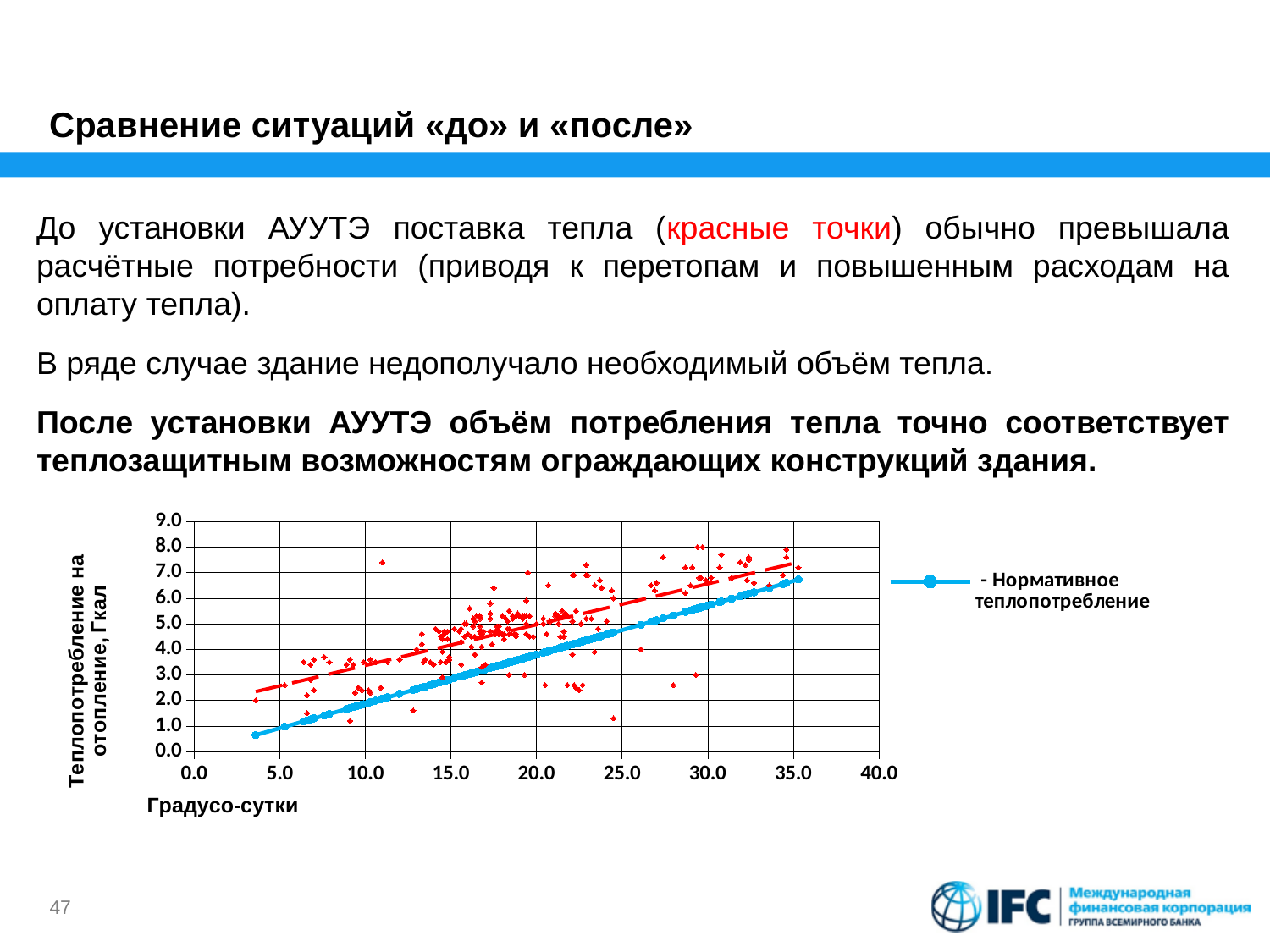
At 35.0 degree-days, which is higher: the red dashed trend line or the blue normative line? The red dashed trend line Is the blue normative heat consumption value at 35.0 degree-days greater or less than 6.0? greater What is the highest value shown on the y axis of the chart? 9.0 What is the legend entry shown next to the chart? - Нормативное теплопотребление What is the highest value shown on the x axis of the chart? 40.0 Do the blue normative heat consumption values rise or fall as the degree-days (Градусо-сутки) increase along the x axis? Rise Do the red points generally rise or fall as the x-axis value increases? Rise Is the blue normative heat consumption value at 25.0 degree-days greater or less than 5.0? less What kind of chart is shown on the slide? Scatter chart What is the title of the x axis of the chart? Градусо-сутки How many series does the chart legend list? 1 Is the blue normative heat consumption value at 30.0 degree-days greater or less than 6.0? less